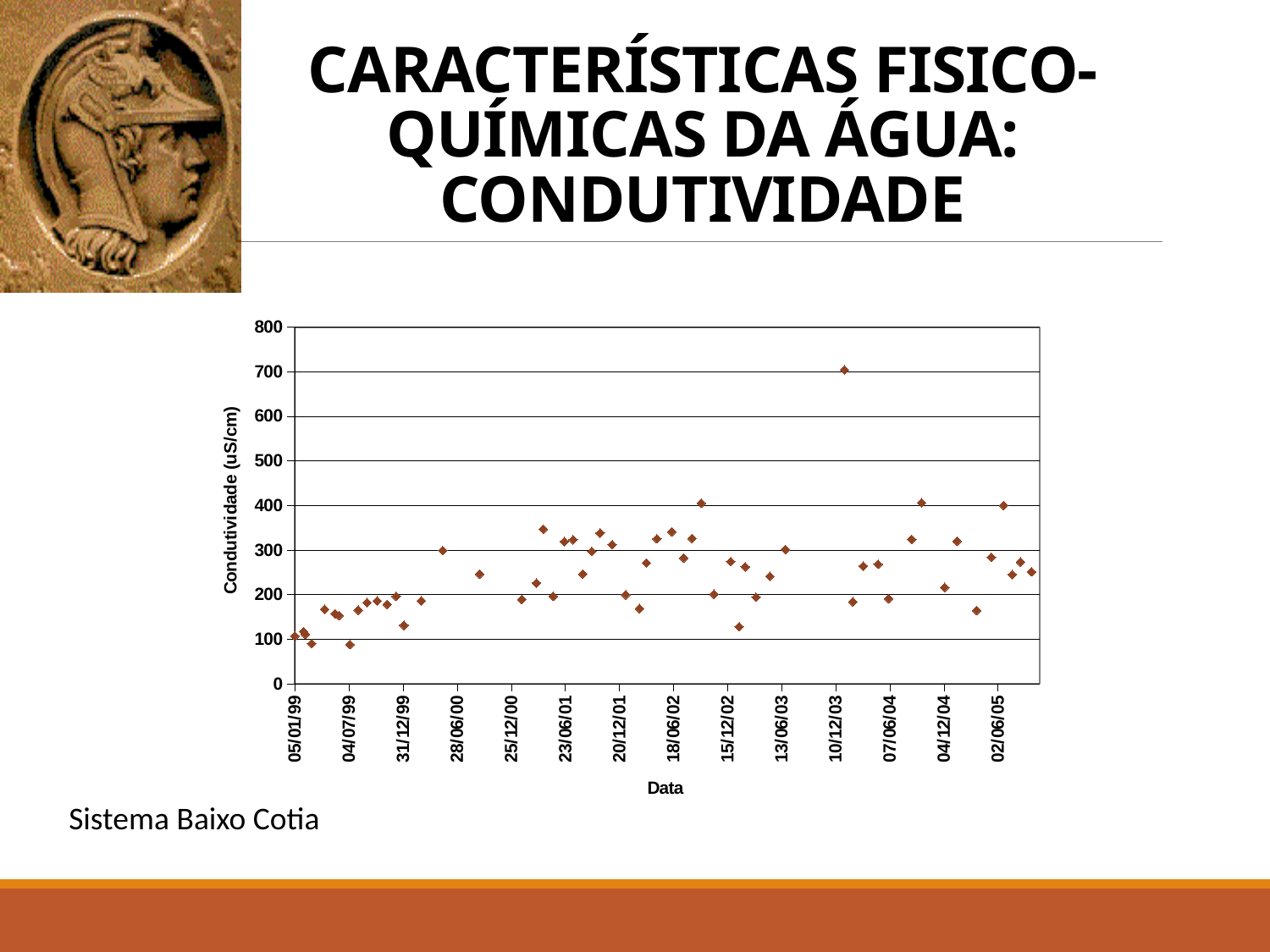
Do the conductivity values generally rise or fall from 1999 to 2005? rise What is the highest value shown on the y axis of the chart? 800 Is the conductivity value plotted at 18/06/02 greater or less than 300? greater What kind of chart is shown on the slide? scatter chart What is the first date label on the x axis of the chart? 05/01/99 How many date labels are shown on the x axis of the chart? 14 What is the label of the x axis of the chart? Data Is the conductivity value plotted at 15/12/02 greater or less than 300? less Is the highest conductivity value plotted on the chart greater or less than 600? greater What is the label of the y axis of the chart? Condutividade (uS/cm) What is the last date label on the x axis of the chart? 02/06/05 Near which x-axis date label does the highest conductivity value occur? 10/12/03